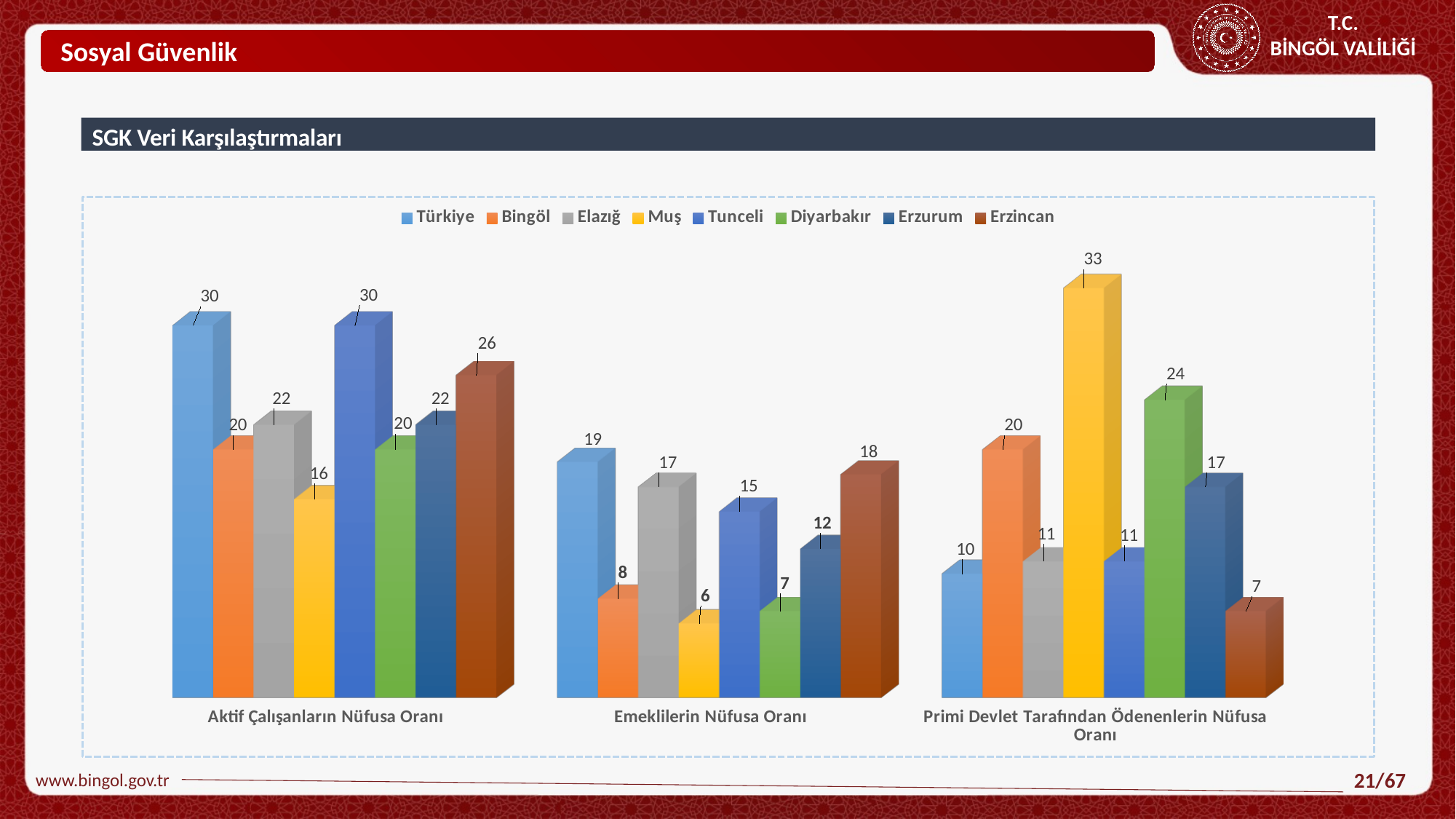
Which series has the highest value in the Primi Devlet Tarafından Ödenenlerin Nüfusa Oranı category? Muş In the Primi Devlet Tarafından Ödenenlerin Nüfusa Oranı category, which is larger: Bingöl or Türkiye? Bingöl How many series does the legend list? 8 Which series has the lowest value in the Emeklilerin Nüfusa Oranı category? Muş What is the value for Muş in the Primi Devlet Tarafından Ödenenlerin Nüfusa Oranı category? 33 What kind of chart is shown on the slide? Bar chart What is the value for Diyarbakır in the Primi Devlet Tarafından Ödenenlerin Nüfusa Oranı category? 24 What is the difference between the Türkiye and Bingöl values in the Emeklilerin Nüfusa Oranı category? 11 In the Aktif Çalışanların Nüfusa Oranı category, which is larger: Erzincan or Elazığ? Erzincan What is the value for Erzincan in the Emeklilerin Nüfusa Oranı category? 18 How many categories are shown on the x axis? 3 What is the value for Bingöl in the Aktif Çalışanların Nüfusa Oranı category? 20